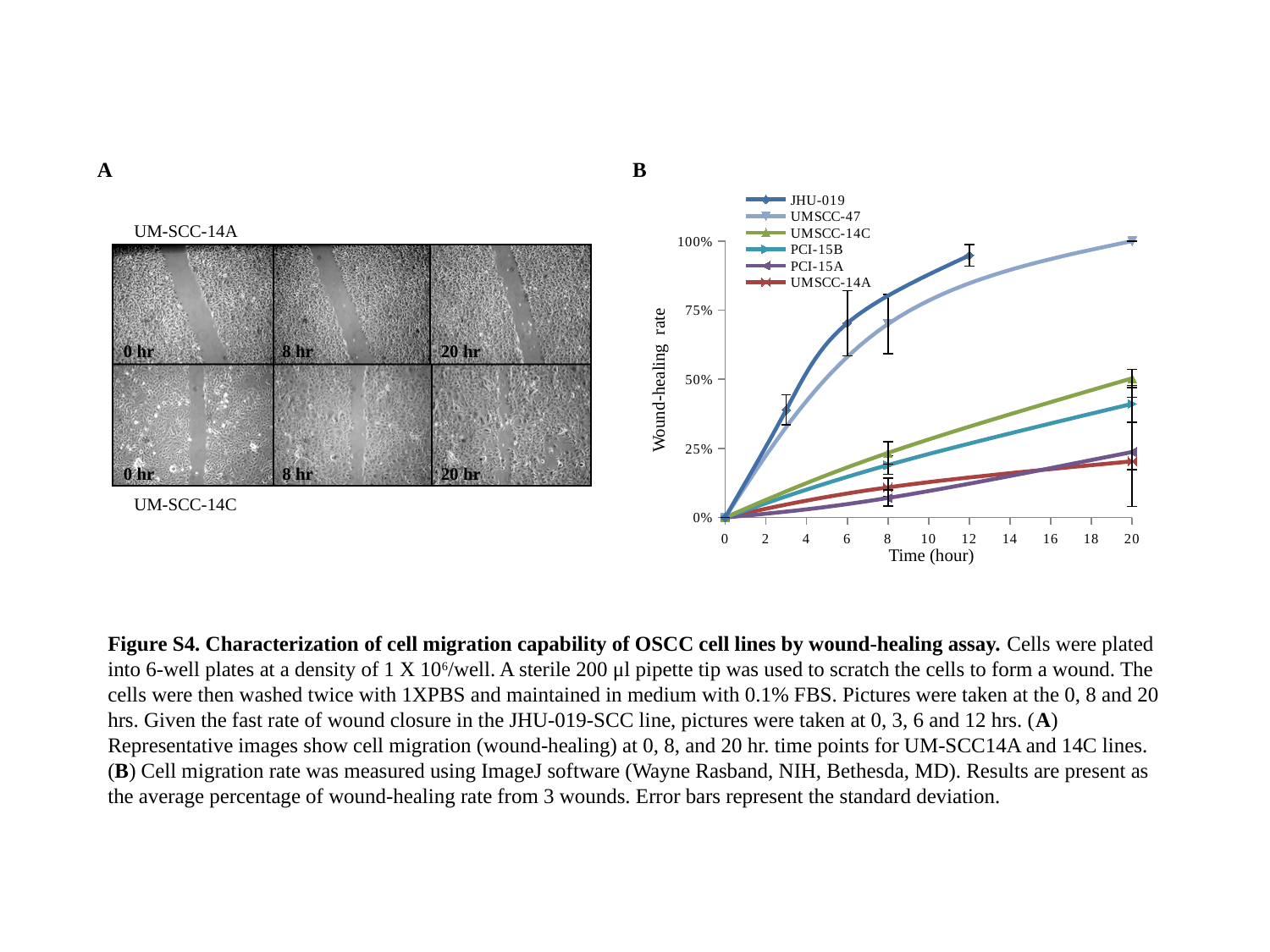
How many series does the legend of the chart in panel B list? 6 In the chart in panel B, which has the higher wound-healing rate at 8 hours, UMSCC-47 or UMSCC-14C? UMSCC-47 What is the x-axis label of the chart in panel B? Time (hour) In the chart in panel B, which has the higher wound-healing rate at 20 hours, UMSCC-14C or PCI-15B? UMSCC-14C In the chart in panel B, what is the wound-healing rate for all cell lines at 0 hours? 0% In the chart in panel B, is the wound-healing rate for UMSCC-47 at 8 hours greater or less than 50%? greater In the chart in panel B, is the wound-healing rate for PCI-15B at 20 hours greater or less than 50%? less What kind of chart is shown in panel B? line chart In the chart in panel B, which series has the highest wound-healing rate at 20 hours? UMSCC-47 In the chart in panel B, do the wound-healing rates rise or fall as time increases? rise In the chart in panel B, is the wound-healing rate for PCI-15A at 8 hours greater or less than 25%? less